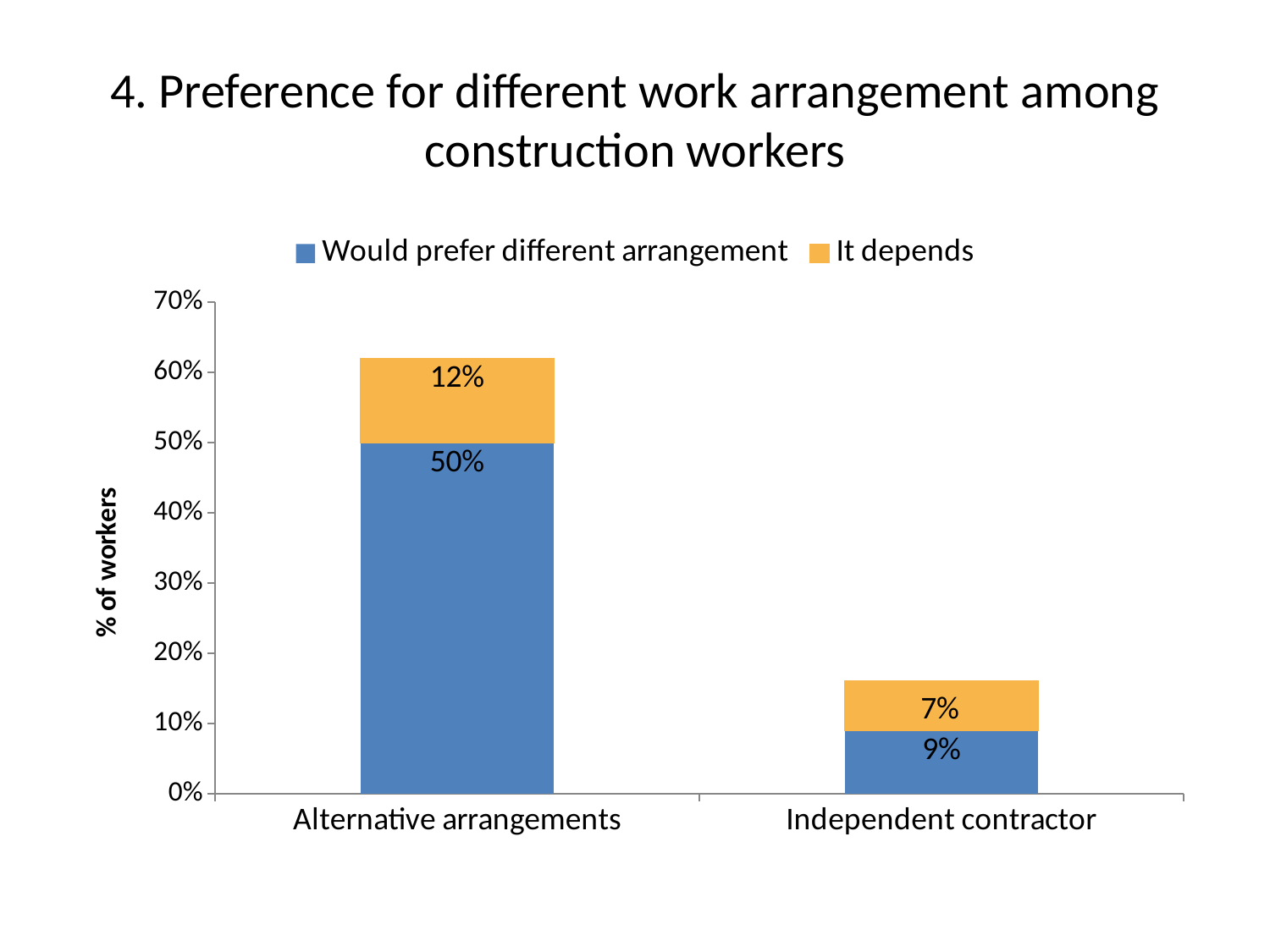
How many series does the legend list? 2 What kind of chart is shown on the slide? Stacked bar chart Which category has the lower 'It depends' value? Independent contractor What is the total of the stacked bar for Alternative arrangements? 62% What is the 'It depends' value for Alternative arrangements? 12% What is the 'It depends' value for Independent contractor? 7% What is the difference between the 'Would prefer different arrangement' values for Alternative arrangements and Independent contractor? 41% Which category has the higher 'Would prefer different arrangement' value? Alternative arrangements What is the total of the stacked bar for Independent contractor? 16% How many categories are shown on the x axis? 2 What percentage of workers in Alternative arrangements would prefer a different arrangement? 50% What is the 'Would prefer different arrangement' value for Independent contractor? 9%